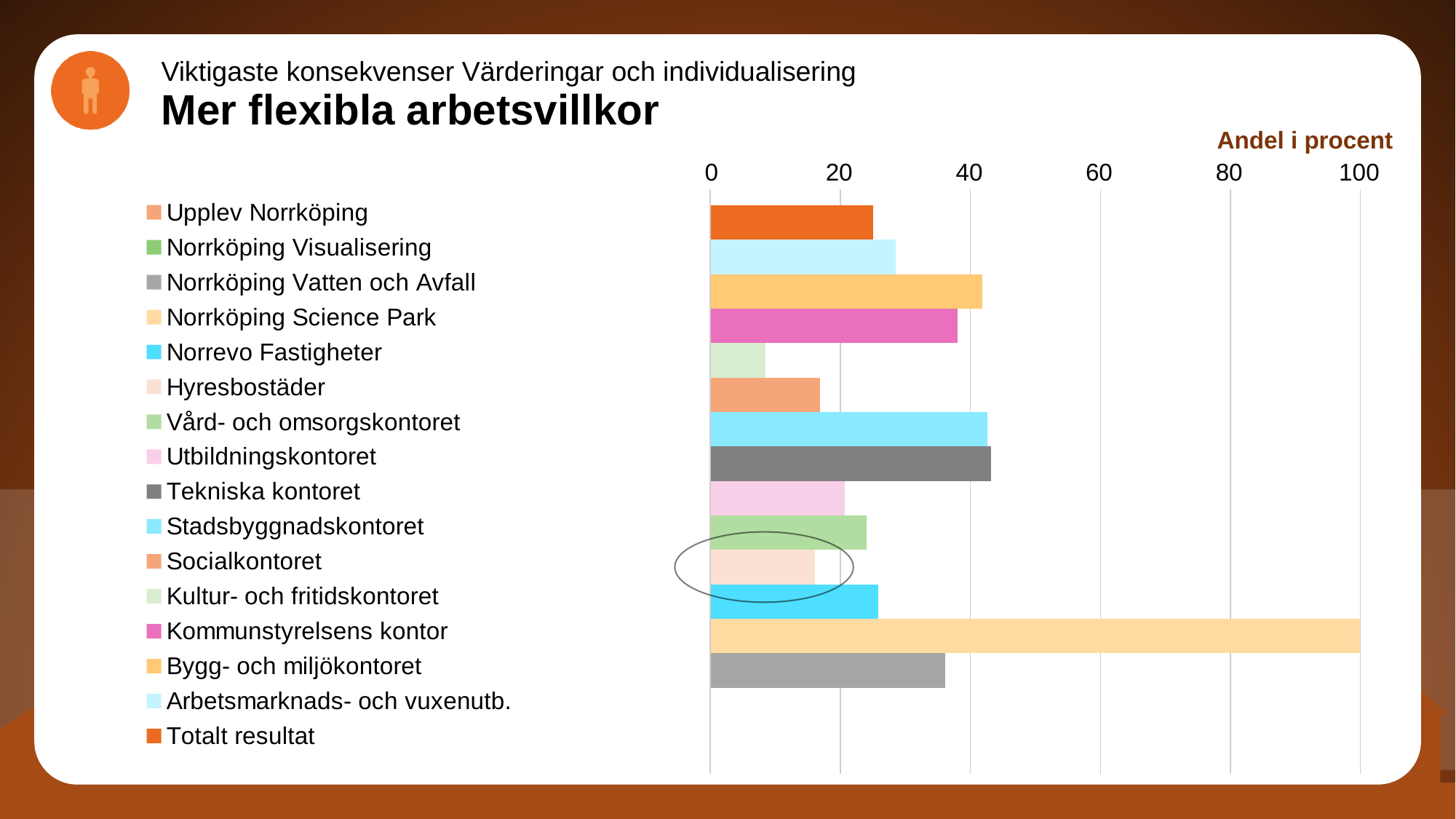
What label is shown above the horizontal axis of the chart? Andel i procent Is the value for Kultur- och fritidskontoret greater or less than 20? less Which is larger, the value for Kommunstyrelsens kontor or the value for Kultur- och fritidskontoret? Kommunstyrelsens kontor Is the value for Norrköping Vatten och Avfall greater or less than 40? less How many entries does the legend list? 16 Is the value for Stadsbyggnadskontoret greater or less than 40? greater What is the value for Norrköping Science Park? 100 Which is larger, the value for Norrköping Science Park or the value for Totalt resultat? Norrköping Science Park Which entry has the highest value in the chart? Norrköping Science Park What kind of chart is shown on the slide? bar chart